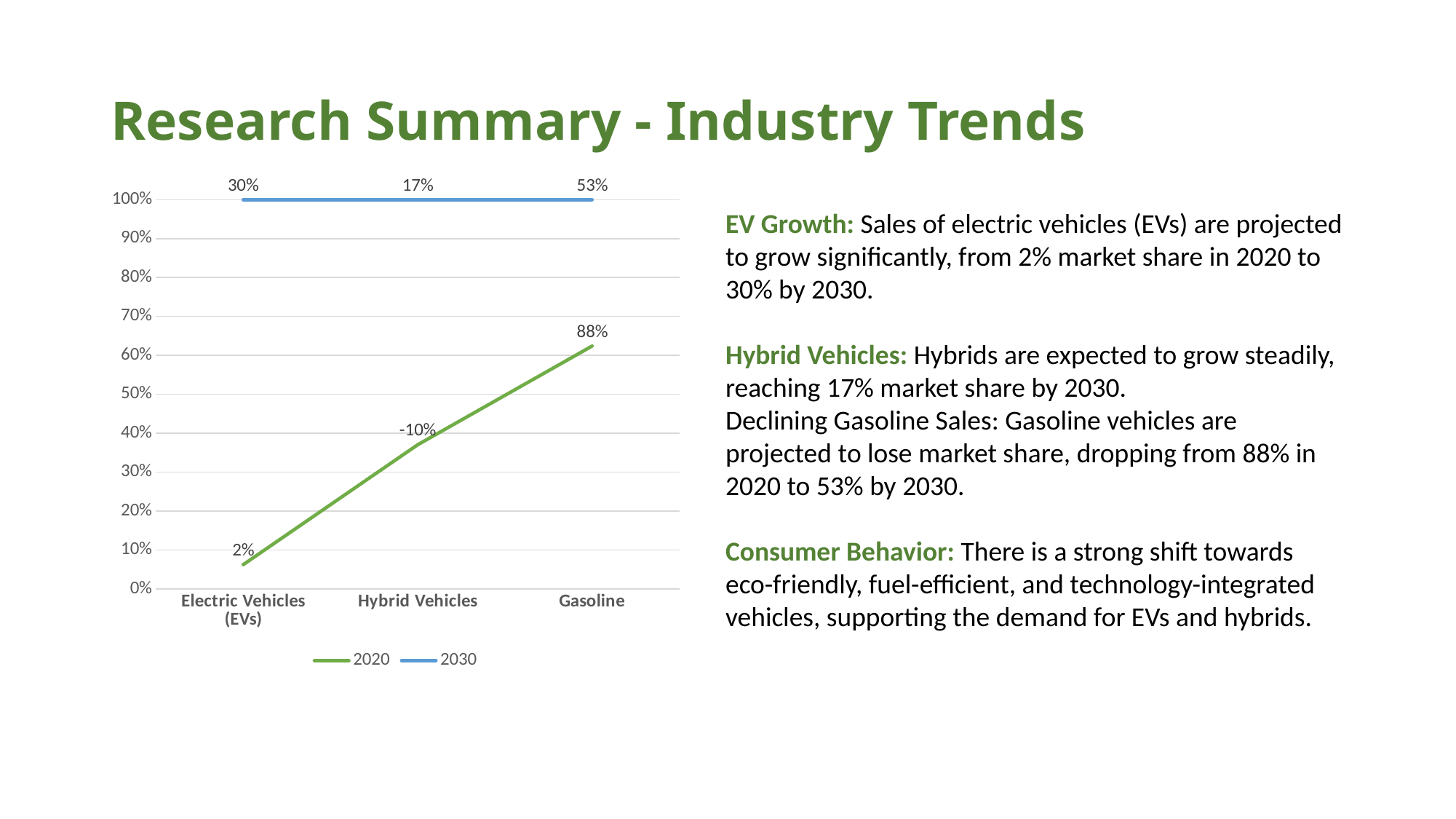
What is the difference between the 2020 and 2030 values for Gasoline? 35% What is the 2030 value for Hybrid Vehicles? 17% Which category has the lowest 2020 value? Hybrid Vehicles What is the 2030 value for Gasoline? 53% What kind of chart is shown on the slide? line chart What is the 2020 value for Gasoline? 88% What is the 2030 value for Electric Vehicles (EVs)? 30% Which series has the larger value for Electric Vehicles (EVs), 2020 or 2030? 2030 How many categories are shown on the x axis of the chart? 3 What is the 2020 value for Hybrid Vehicles? -10% Which category has the highest 2030 value? Gasoline How many series does the chart legend list? 2